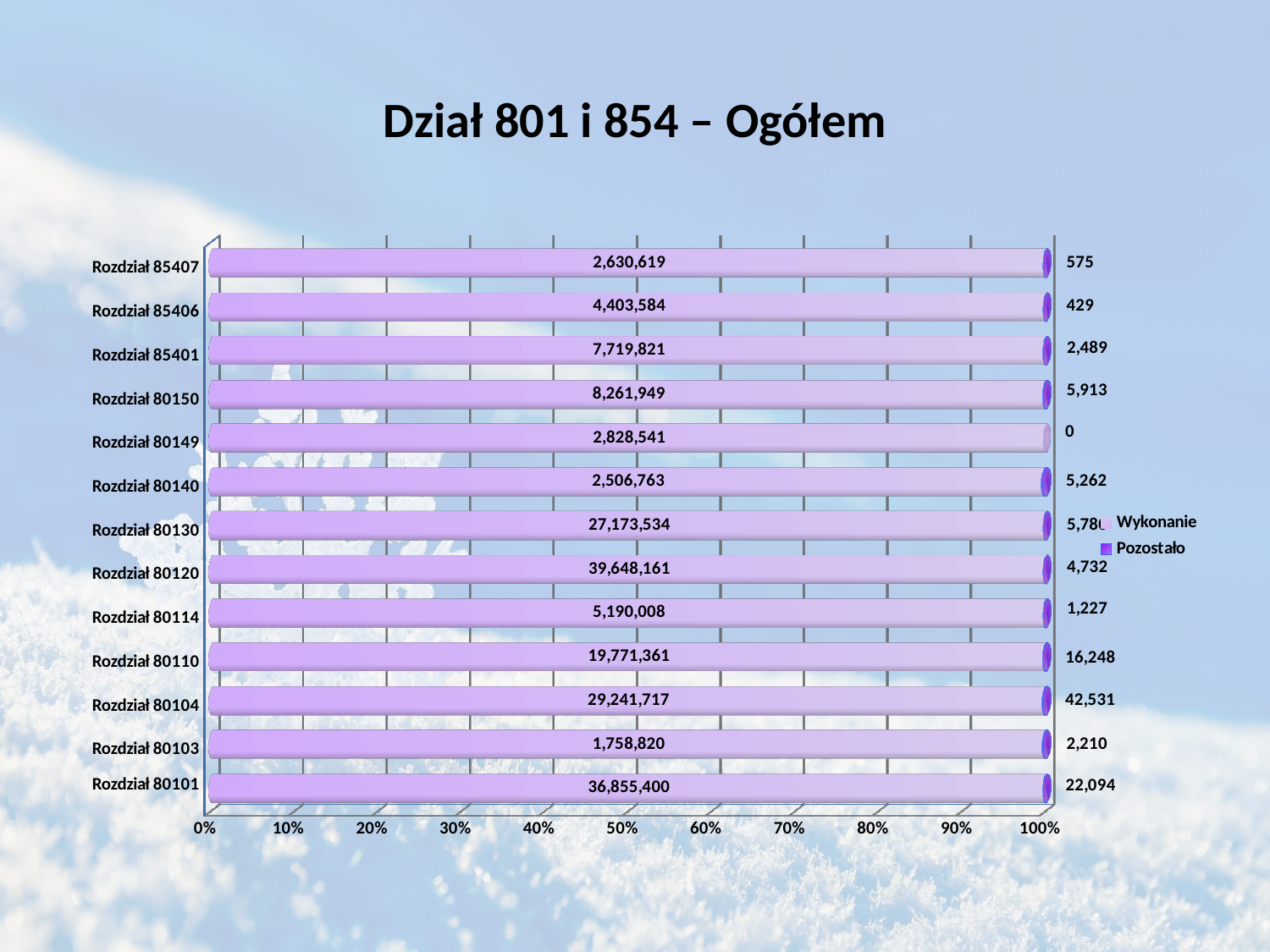
How many categories (Rozdział) are shown on the chart? 13 How many series does the legend list? 2 What is the title of the slide? Dział 801 i 854 – Ogółem What is the Wykonanie value for Rozdział 80120? 39,648,161 Which category has the highest Pozostało value? Rozdział 80104 Which has a larger Pozostało value, Rozdział 80110 or Rozdział 80101? Rozdział 80101 What is the Pozostało value for Rozdział 80104? 42,531 What is the Wykonanie value for Rozdział 85406? 4,403,584 What is the difference between the Wykonanie values of Rozdział 80120 and Rozdział 80101? 2,792,761 Which category has the lowest Wykonanie value? Rozdział 80103 What is the Pozostało value for Rozdział 80149? 0 Which category has the highest Wykonanie value? Rozdział 80120